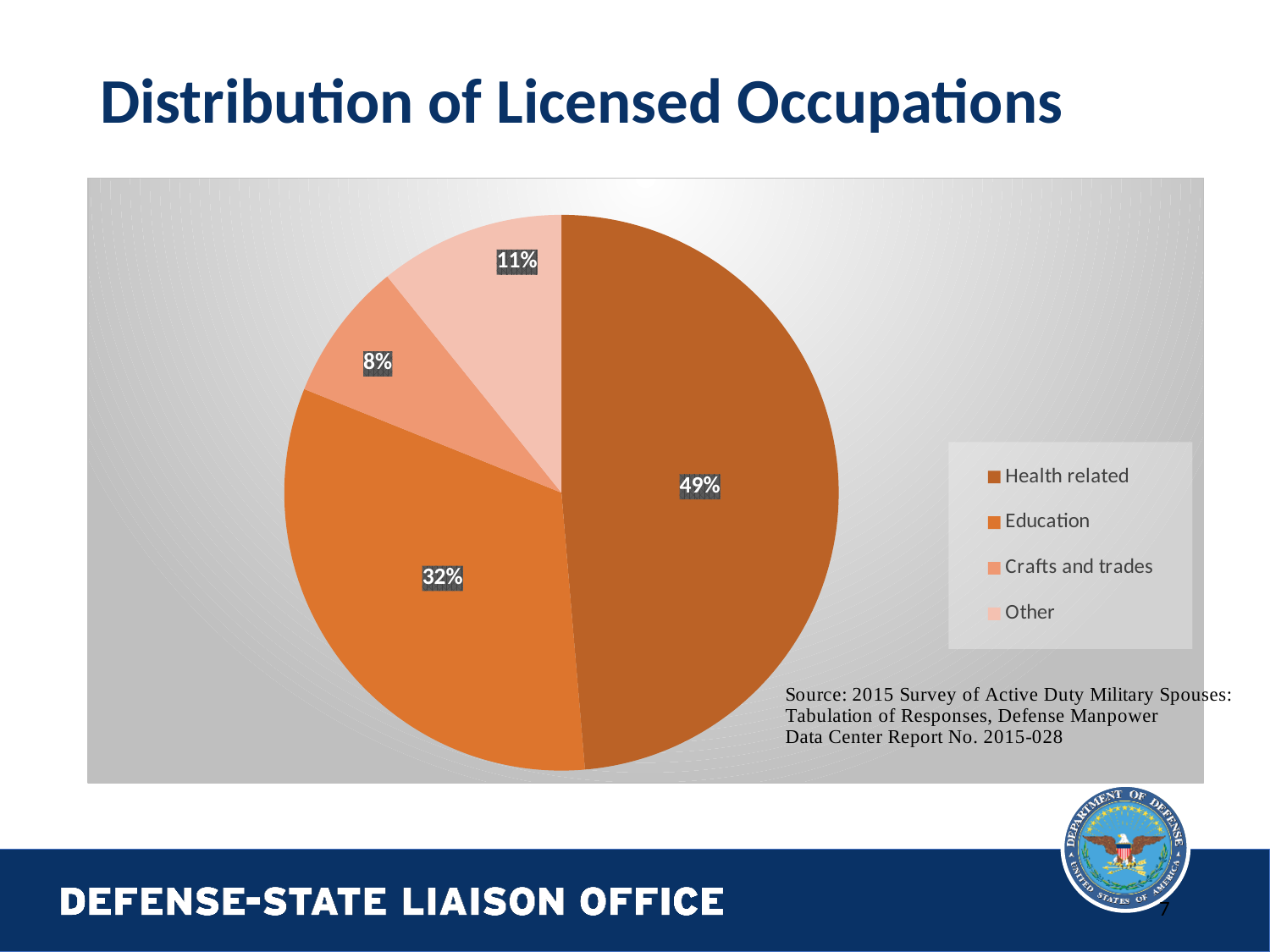
What is the title of the slide containing the chart? Distribution of Licensed Occupations How many categories are shown in the pie chart? 4 What kind of chart is shown on the slide? Pie chart Which category has the smallest slice? Crafts and trades What is the value shown for Crafts and trades? 8% What is the value shown for Education? 32% Which category has the largest slice? Health related Which is larger, Education or Other? Education What is the difference between the Health related and Education shares? 17% What share of the pie does Health related occupy? 49% What share of the pie does the Other slice occupy? 11% What is the difference between the Other and Crafts and trades shares? 3%